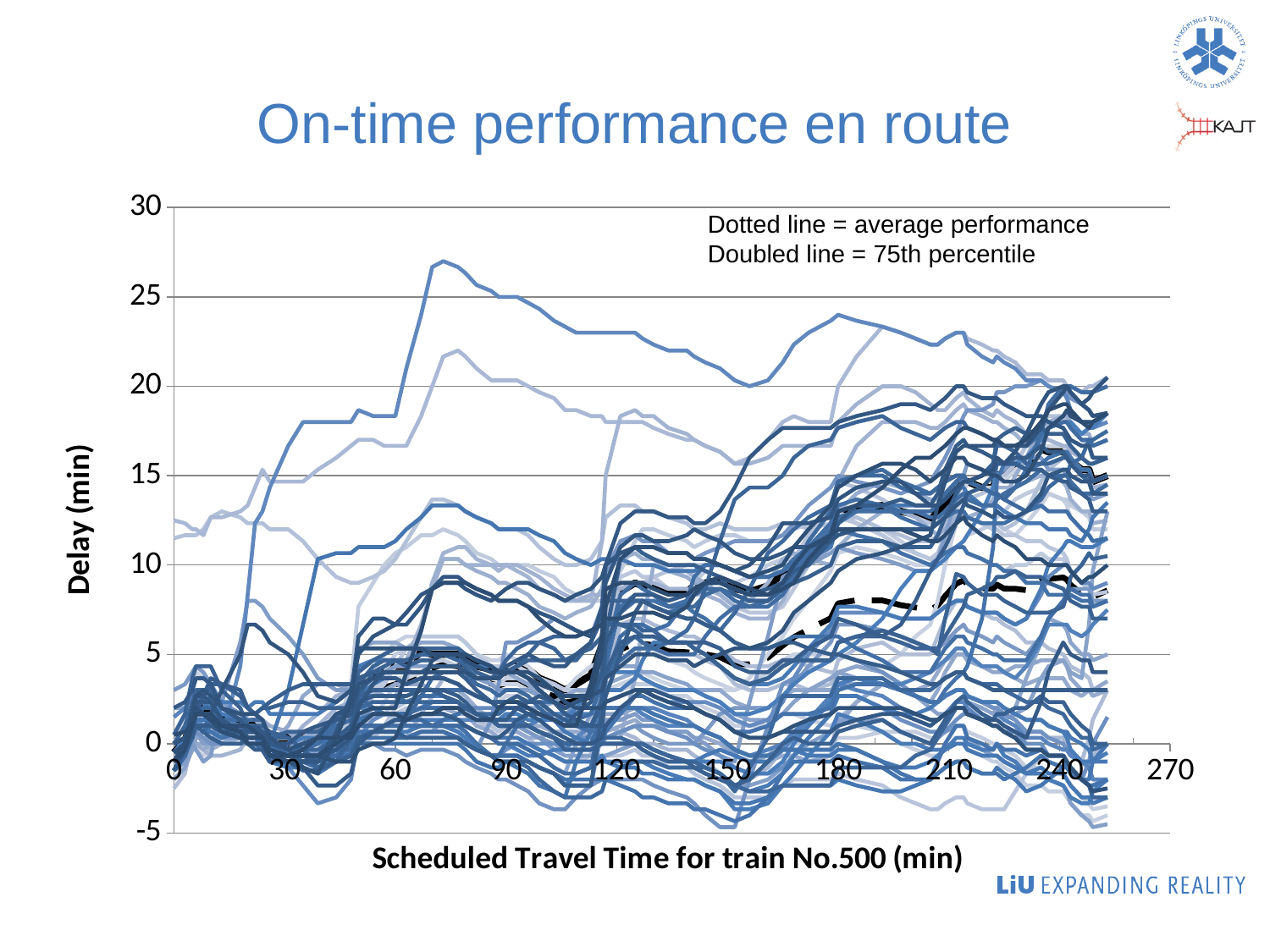
Is the dotted average line at a scheduled travel time of 240 min greater or less than 15? less Is the dotted average line at a scheduled travel time of 240 min greater or less than 5? greater Is the dotted average line at a scheduled travel time of 30 min greater or less than 5? less What kind of chart is shown on the slide? line chart According to the chart's note, what does the dotted line represent? average performance Does the dotted average delay line generally rise or fall as scheduled travel time increases? rise What is the title of the chart? On-time performance en route